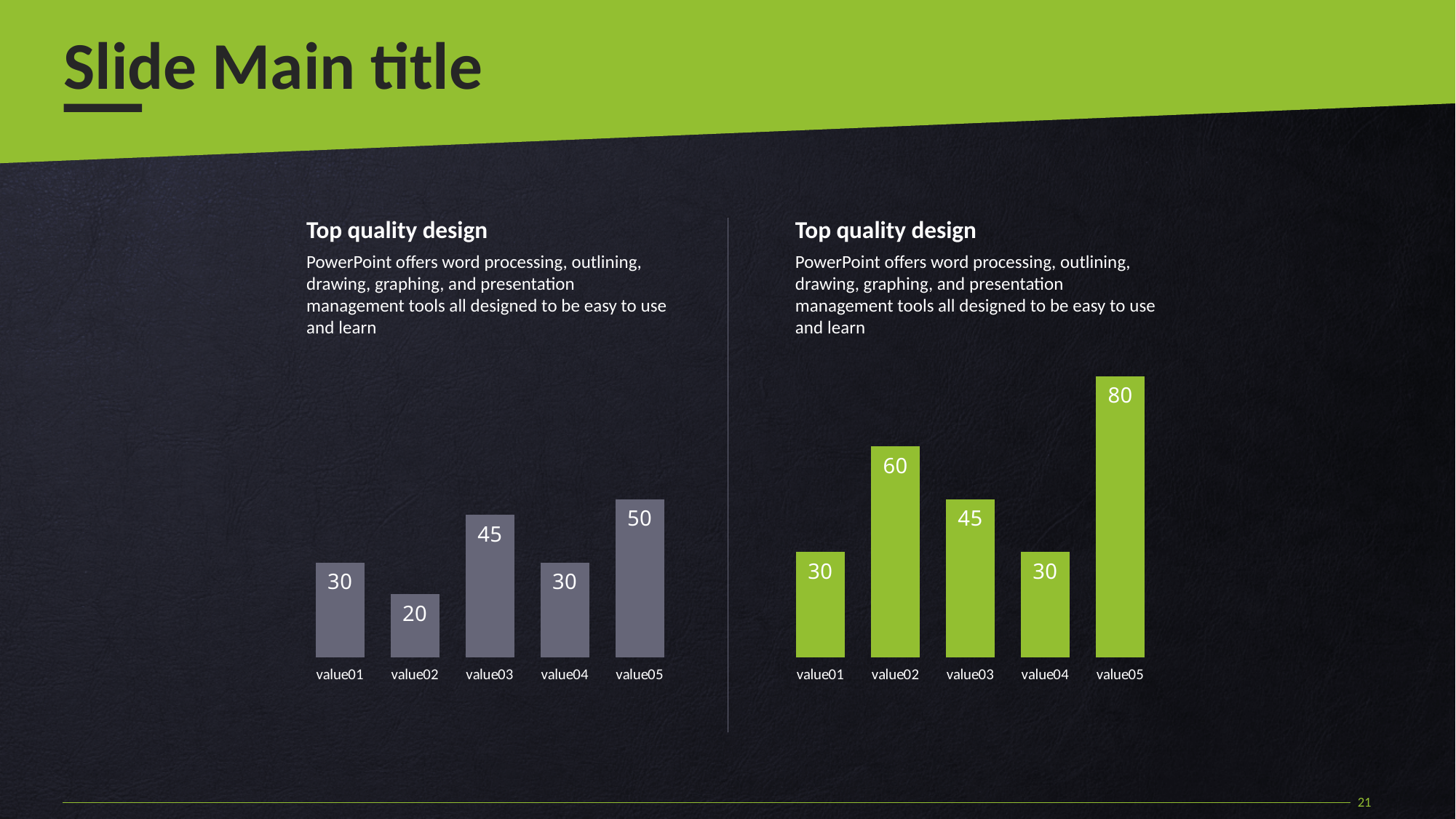
In the right chart, what is the difference between value05 and value01? 50 In the left chart, what is the value for value03? 45 What kind of chart is the right chart? bar chart In the right chart, which category has the highest value? value05 In the right chart, what is the value for value02? 60 In the left chart, which category has the highest value? value05 In the left chart, what is the difference between value05 and value02? 30 In the left chart, which category has the lowest value? value02 In the right chart, which is larger, value02 or value03? value02 How many categories does the left chart show? 5 What colour are the bars in the right chart? green In the right chart, what is the value for value04? 30